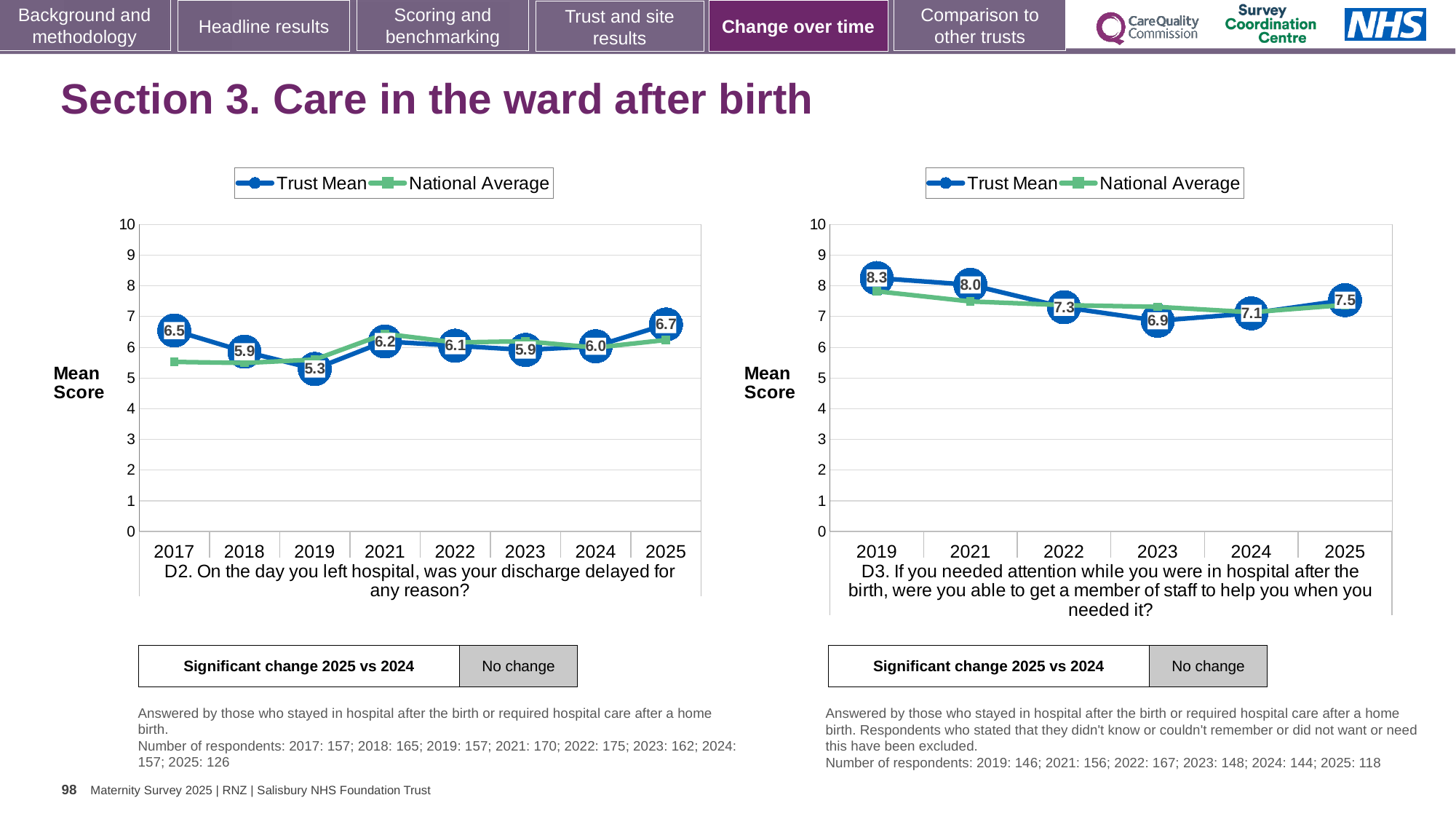
In the D2 chart (left), which year has the highest Trust Mean score? 2025 In the D2 chart (left), what is the Trust Mean score for 2025? 6.7 How many series does the legend of the D3 chart (right) list? 2 In the D3 chart (right), what is the difference between the Trust Mean scores for 2019 and 2023? 1.4 In the D2 chart (left), which year has the lowest Trust Mean score? 2019 In the D2 chart (left), how many years are shown on the x axis? 8 In the D3 chart (right), what is the Trust Mean score for 2023? 6.9 In the D2 chart (left), what is the Trust Mean score for 2019? 5.3 In the D3 chart (right), which year has the highest Trust Mean score? 2019 In the D2 chart (left), what is the difference between the Trust Mean scores for 2025 and 2024? 0.7 What kind of chart is the D2 chart (left)? Line chart In the D3 chart (right), is the Trust Mean score for 2019 greater or less than 8? greater